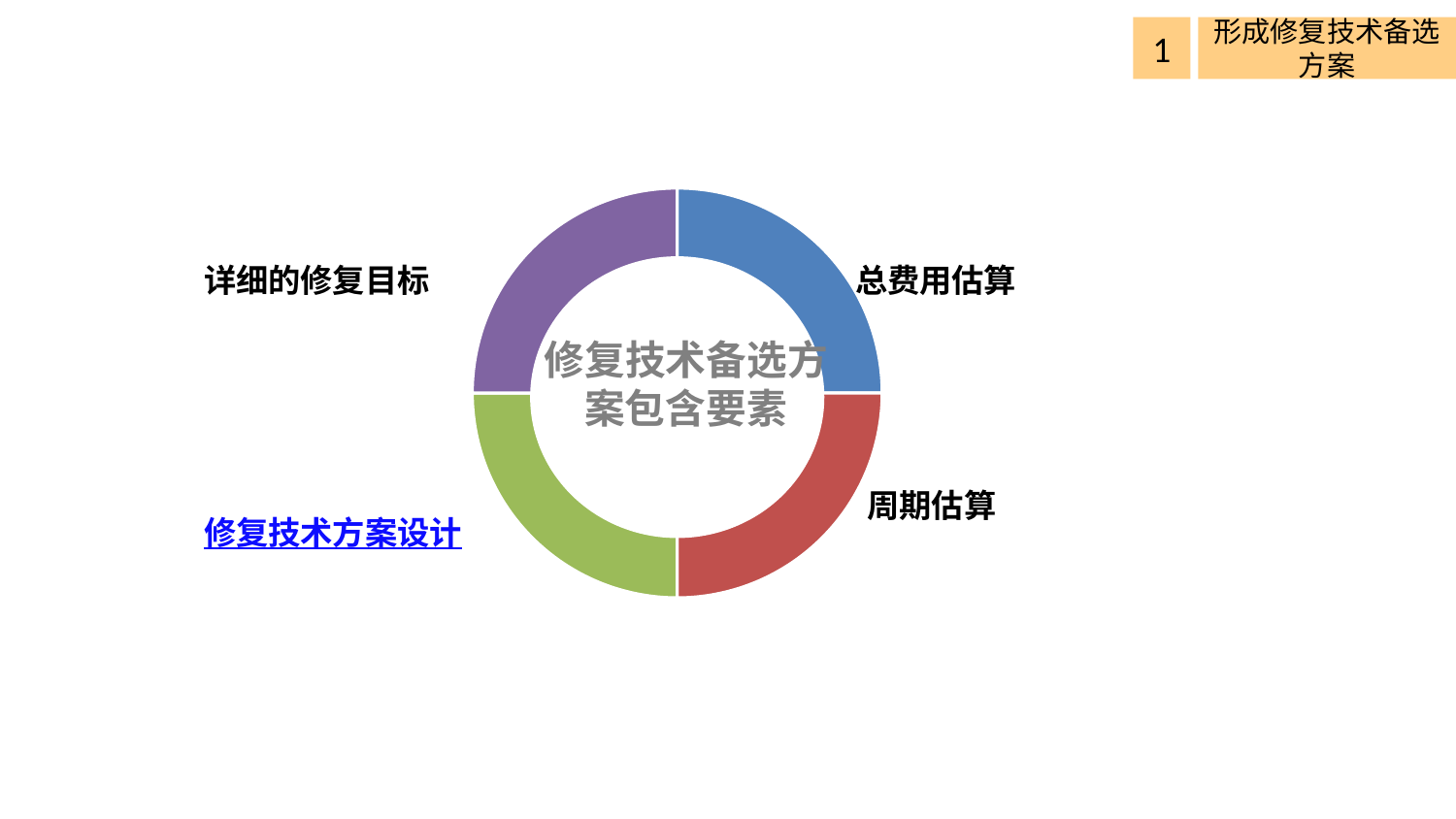
How many segments does the doughnut chart have? 4 Which label is attached to the green segment of the doughnut chart? 修复技术方案设计 What text appears in the centre of the doughnut chart? 修复技术备选方案包含要素 What kind of chart is shown on the slide? Doughnut chart Which label is attached to the red segment of the doughnut chart? 周期估算 Which colour is the segment labelled 总费用估算? Blue Which label is attached to the purple segment of the doughnut chart? 详细的修复目标